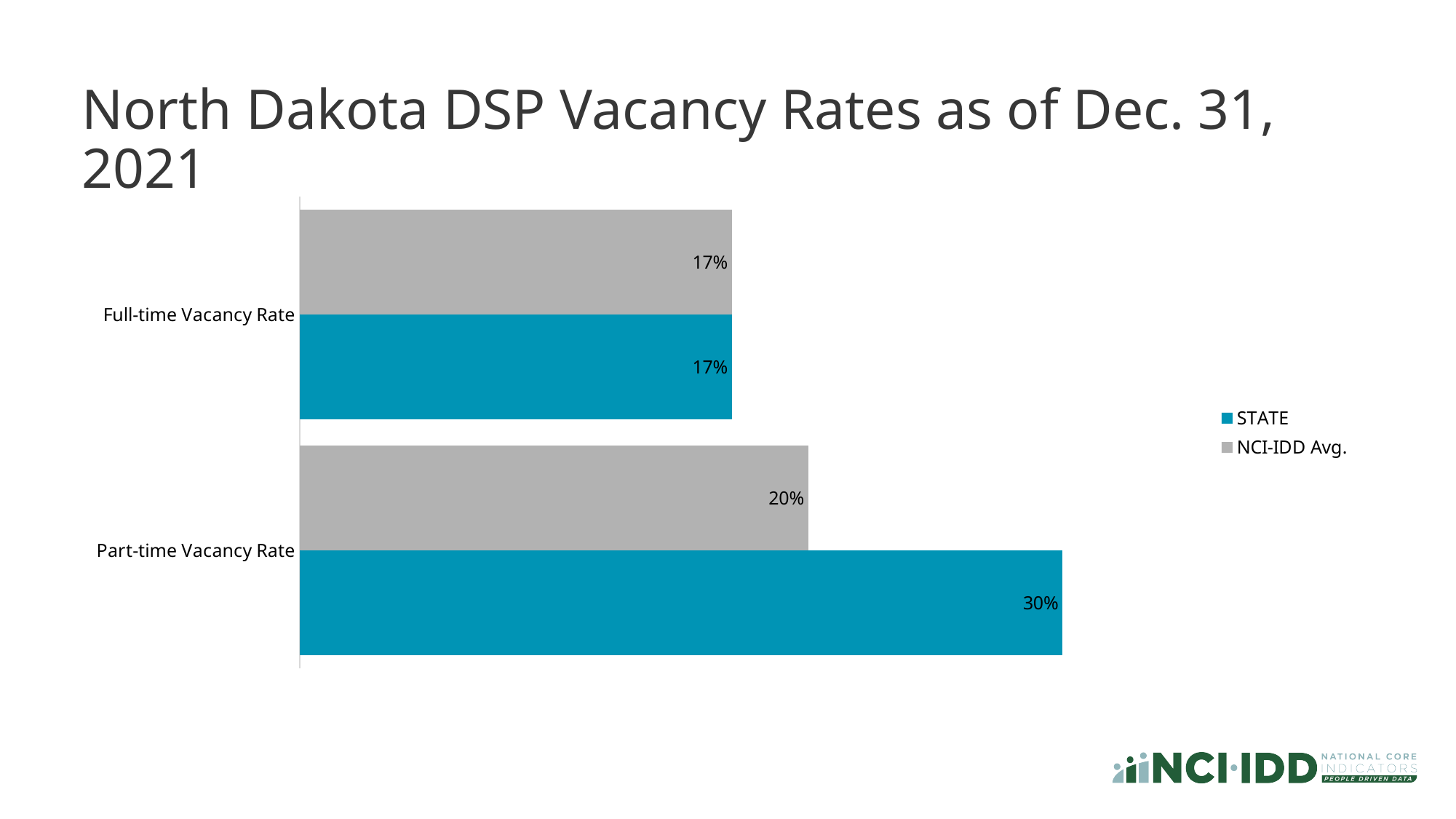
What is the NCI-IDD Avg. value for the Part-time Vacancy Rate? 20% What is the NCI-IDD Avg. value for the Full-time Vacancy Rate? 17% Which category has the highest STATE value? Part-time Vacancy Rate For the Part-time Vacancy Rate, which is larger: the STATE value or the NCI-IDD Avg. value? STATE Which category has the lowest NCI-IDD Avg. value? Full-time Vacancy Rate What is the difference between the STATE and NCI-IDD Avg. values for the Part-time Vacancy Rate? 10% How many categories are shown on the chart? 2 What is the difference between the STATE Part-time Vacancy Rate and the STATE Full-time Vacancy Rate? 13% What is the STATE value for the Part-time Vacancy Rate? 30% What is the STATE value for the Full-time Vacancy Rate? 17% What kind of chart is shown on the slide? Bar chart How many series does the legend list? 2